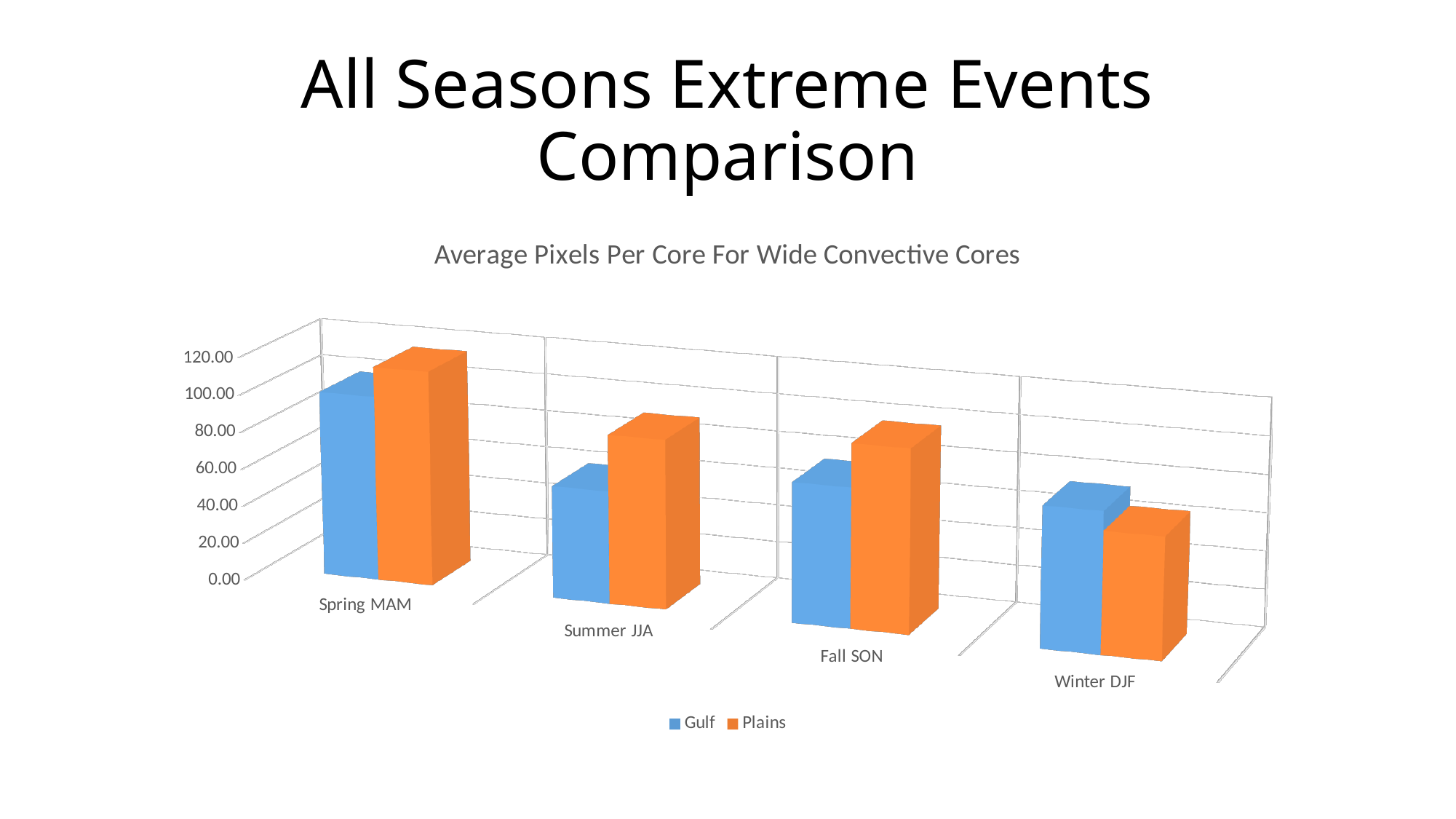
Which colour represents the Plains series? orange How many seasons (categories) are shown on the x axis? 4 What kind of chart is shown on the slide? bar chart What is the title of the chart? Average Pixels Per Core For Wide Convective Cores In which season is the Plains value highest? Spring MAM For Summer JJA, which is larger, Gulf or Plains? Plains Is the Plains value for Spring MAM greater or less than 80.00? greater How many series does the legend list? 2 For Winter DJF, which is larger, Gulf or Plains? Gulf Is the Gulf value for Summer JJA greater or less than 100.00? less In which season is the Plains value lowest? Winter DJF For Spring MAM, which is larger, Gulf or Plains? Plains